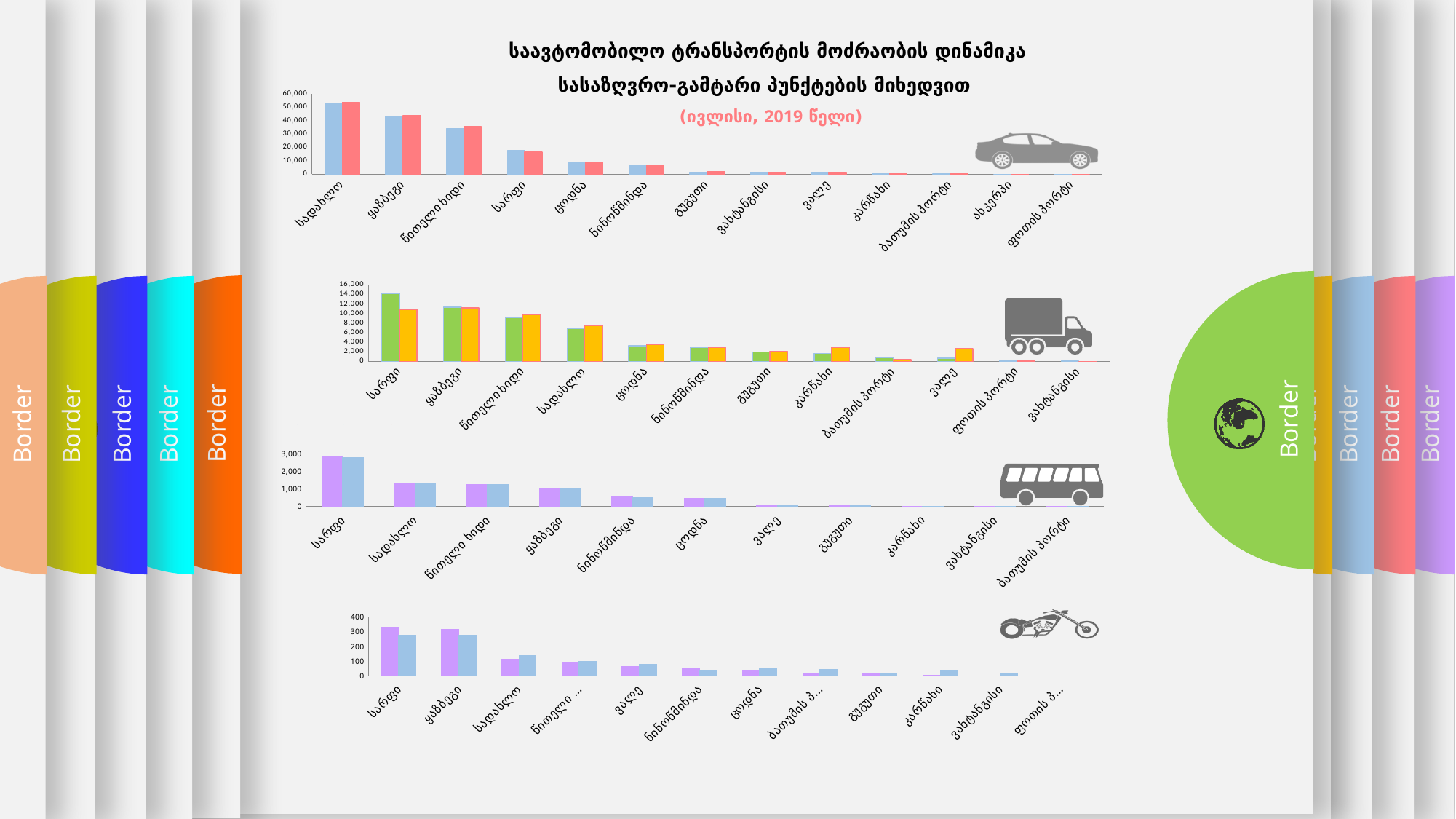
In the third chart from the top (bus icon), are the values for ნინოწმინდა greater or less than 1,000? less In the top chart (car icon), how many categories are shown on the x axis? 13 How many charts are shown on the slide? 4 In the second chart from the top (truck icon), which category has the highest value? სარფი In the bottom chart (motorcycle icon), which has larger values, სარფი or ვალე? სარფი In the top chart (car icon), are the values for სარფი greater or less than 20,000? less In the top chart (car icon), do the values generally rise or fall from left to right along the x axis? fall What kind of chart is the top chart on the slide (with the car icon)? bar chart In the second chart from the top (truck icon), how many categories are shown on the x axis? 12 In the third chart from the top (bus icon), which category has the highest values? სარფი In the second chart from the top (truck icon), are the values for ცოდნა greater or less than 8,000? less In the top chart (car icon), which category has the highest values? სადახლო